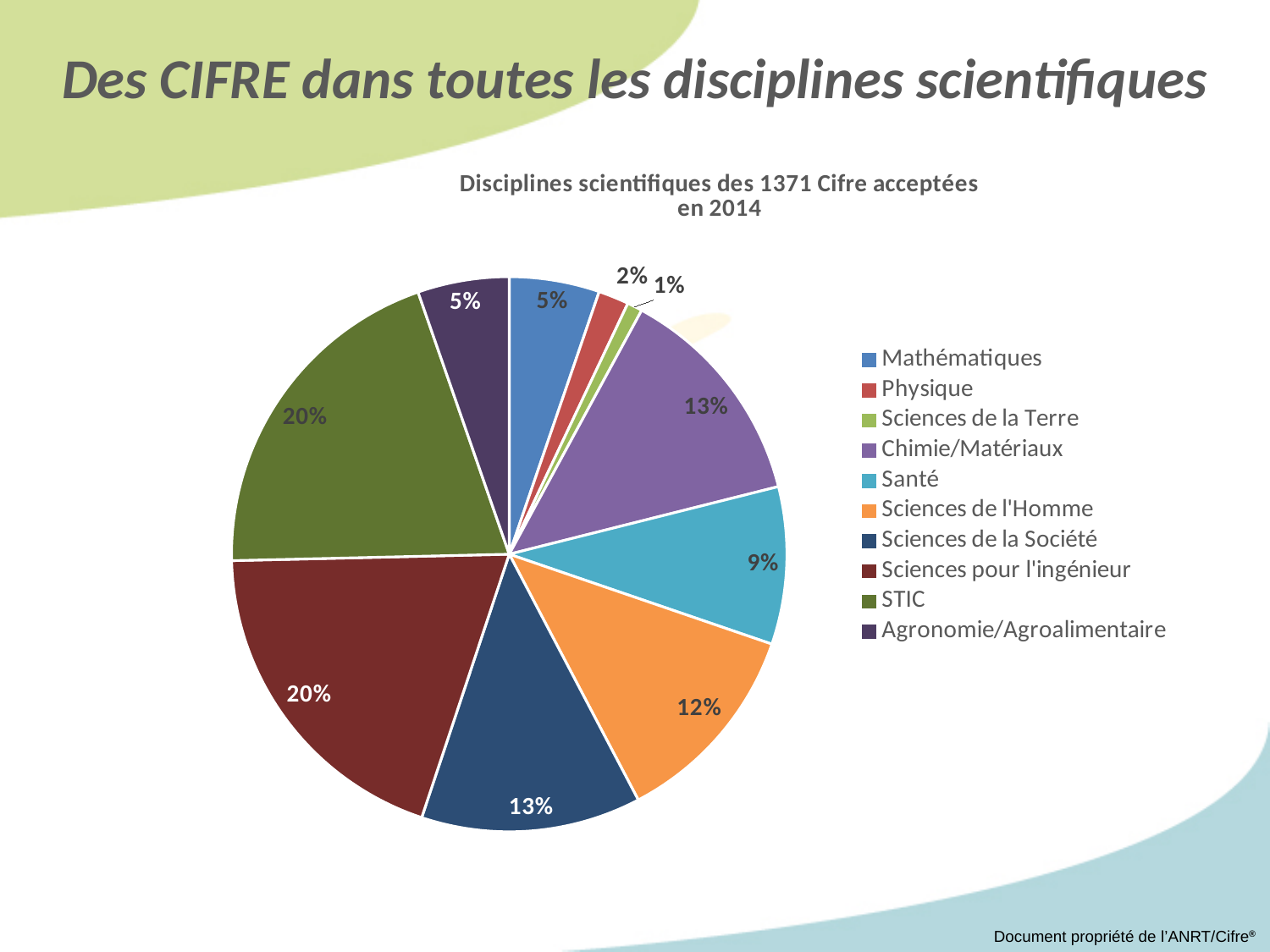
How many categories does the legend list? 10 What share of the pie does Physique represent? 2% What share of the pie does Chimie/Matériaux represent? 13% What is the difference in percentage points between the STIC slice and the Mathématiques slice? 15 What share of the pie does Santé represent? 9% Which discipline has the smallest slice of the pie? Sciences de la Terre What kind of chart is shown on the slide? pie chart What is the difference in percentage points between the Sciences de la Société slice and the Santé slice? 4 What colour is the slice for Sciences pour l'ingénieur? dark red What is the title of the chart? Disciplines scientifiques des 1371 Cifre acceptées en 2014 Which is larger, the slice for Santé or the slice for Sciences de l'Homme? Sciences de l'Homme